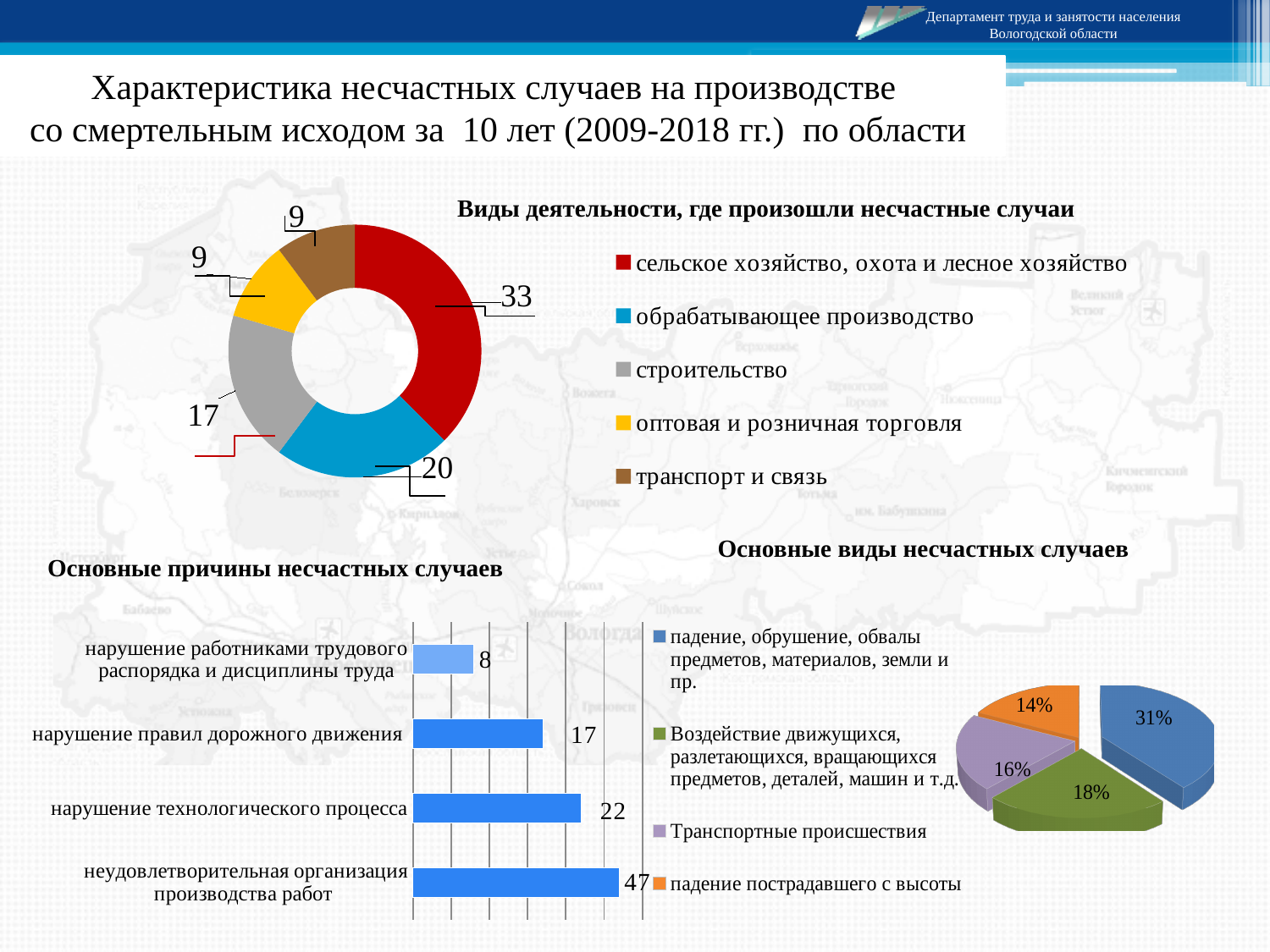
In the chart 'Виды деятельности, где произошли несчастные случаи', what is the value for 'строительство'? 17 In the chart 'Основные причины несчастных случаев', which category has the lowest value? нарушение работниками трудового распорядка и дисциплины труда What kind of chart is 'Основные причины несчастных случаев'? bar chart In the chart 'Виды деятельности, где произошли несчастные случаи', what is the difference between 'сельское хозяйство, охота и лесное хозяйство' and 'обрабатывающее производство'? 13 In the chart 'Основные виды несчастных случаев', which category has the largest share? падение, обрушение, обвалы предметов, материалов, земли и пр. In the chart 'Основные виды несчастных случаев', what share does 'Транспортные происшествия' have? 16% In the chart 'Виды деятельности, где произошли несчастные случаи', which category has the highest value? сельское хозяйство, охота и лесное хозяйство In the chart 'Основные причины несчастных случаев', what is the difference between 'нарушение технологического процесса' and 'нарушение правил дорожного движения'? 5 How many categories does the legend of the chart 'Виды деятельности, где произошли несчастные случаи' list? 5 In the chart 'Основные причины несчастных случаев', what is the value for 'неудовлетворительная организация производства работ'? 47 In the chart 'Основные виды несчастных случаев', which is larger: 'Воздействие движущихся, разлетающихся, вращающихся предметов, деталей, машин и т.д.' or 'падение пострадавшего с высоты'? Воздействие движущихся, разлетающихся, вращающихся предметов, деталей, машин и т.д. In the chart 'Виды деятельности, где произошли несчастные случаи', what is the value for 'сельское хозяйство, охота и лесное хозяйство'? 33